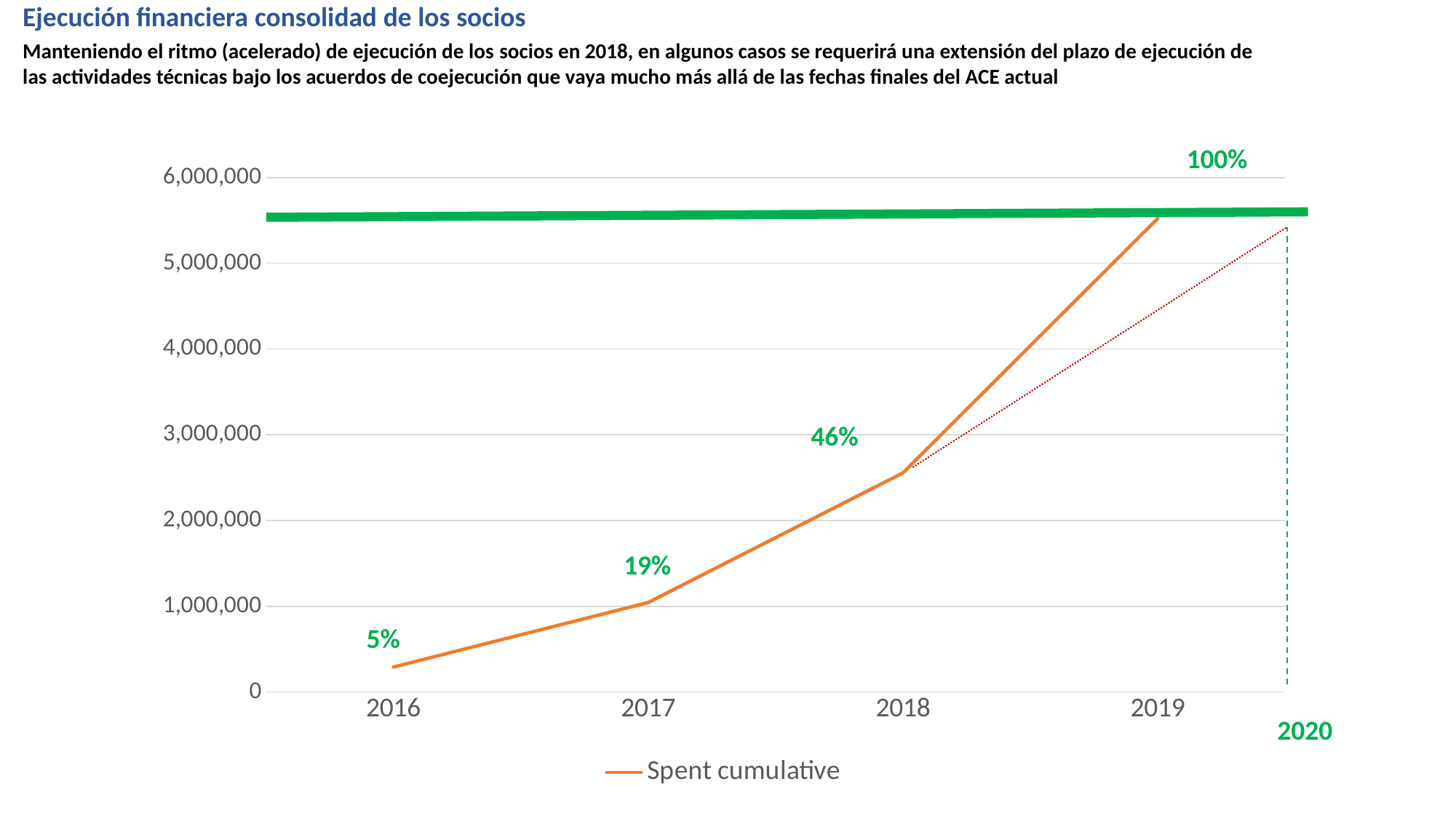
Is the Spent cumulative value for 2016 greater or less than 1,000,000? less What series name does the legend show? Spent cumulative What percentage label is shown for 2018? 46% Is the Spent cumulative value for 2019 greater or less than 5,000,000? greater In which year is the Spent cumulative value lowest? 2016 What percentage label is shown for 2016? 5% Does the Spent cumulative line rise or fall from 2016 to 2019? rise How many series does the legend list? 1 What percentage label is shown for 2017? 19% What kind of chart is shown on the slide? line chart Is the Spent cumulative value for 2018 greater or less than 2,000,000? greater